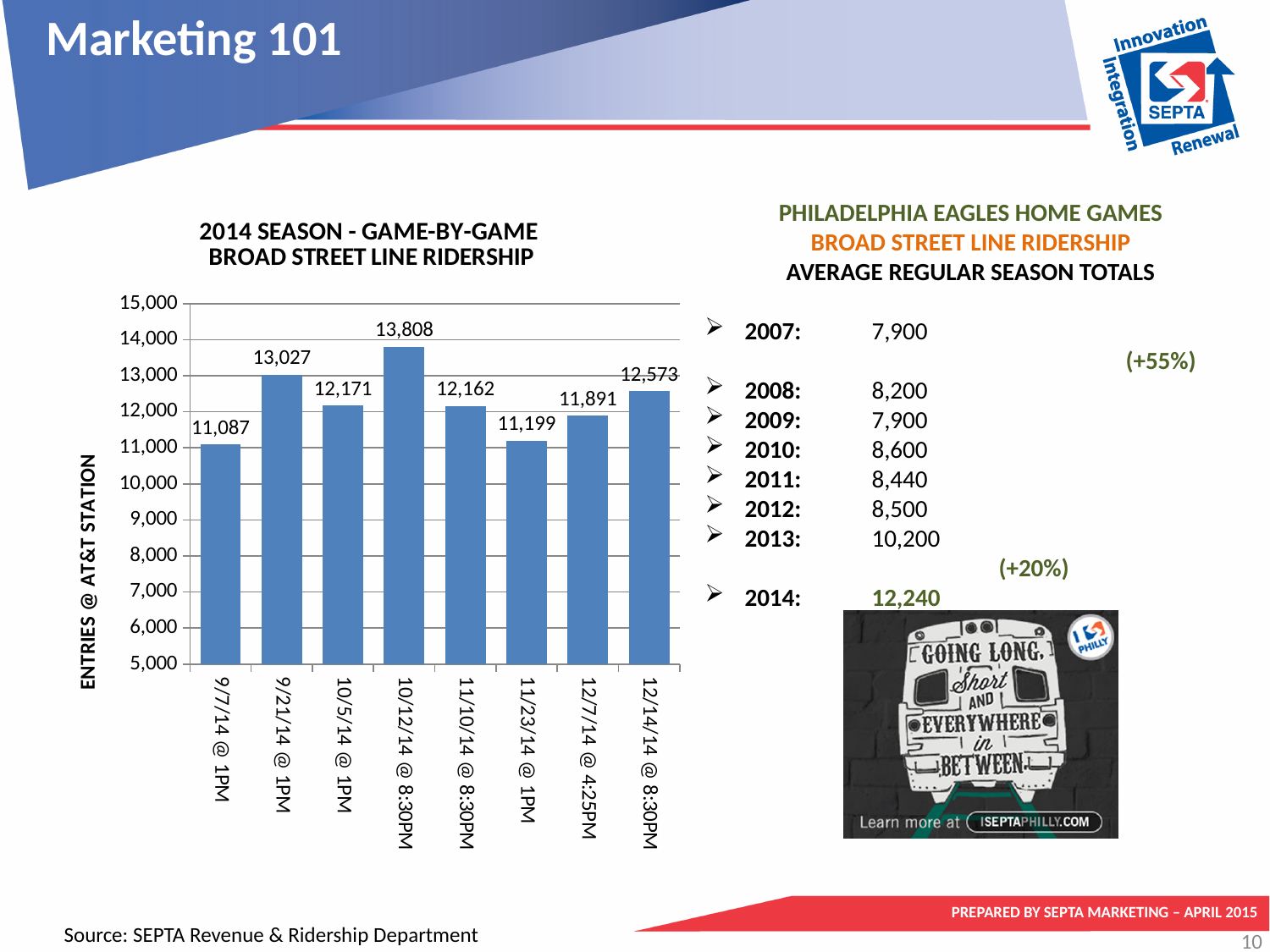
Which game had higher ridership, 11/23/14 @ 1PM or 12/7/14 @ 4:25PM? 12/7/14 @ 4:25PM What is the difference in ridership between the 9/21/14 @ 1PM game and the 9/7/14 @ 1PM game? 1,940 What is the ridership value for the 10/12/14 @ 8:30PM game? 13,808 What is the ridership value for the 9/7/14 @ 1PM game? 11,087 How many games (bars) are plotted in the 2014 Season Game-by-Game Broad Street Line Ridership chart? 8 What type of chart is shown on the slide? bar chart Is the ridership value for the 10/5/14 @ 1PM game greater or less than 12,000? greater Which game has the lowest Broad Street Line ridership? 9/7/14 @ 1PM Which game has the highest Broad Street Line ridership? 10/12/14 @ 8:30PM What is the difference in ridership between the 10/12/14 @ 8:30PM game and the 11/10/14 @ 8:30PM game? 1,646 What is the label of the vertical axis of the chart? ENTRIES @ AT&T STATION What is the ridership value for the 12/14/14 @ 8:30PM game? 12,573